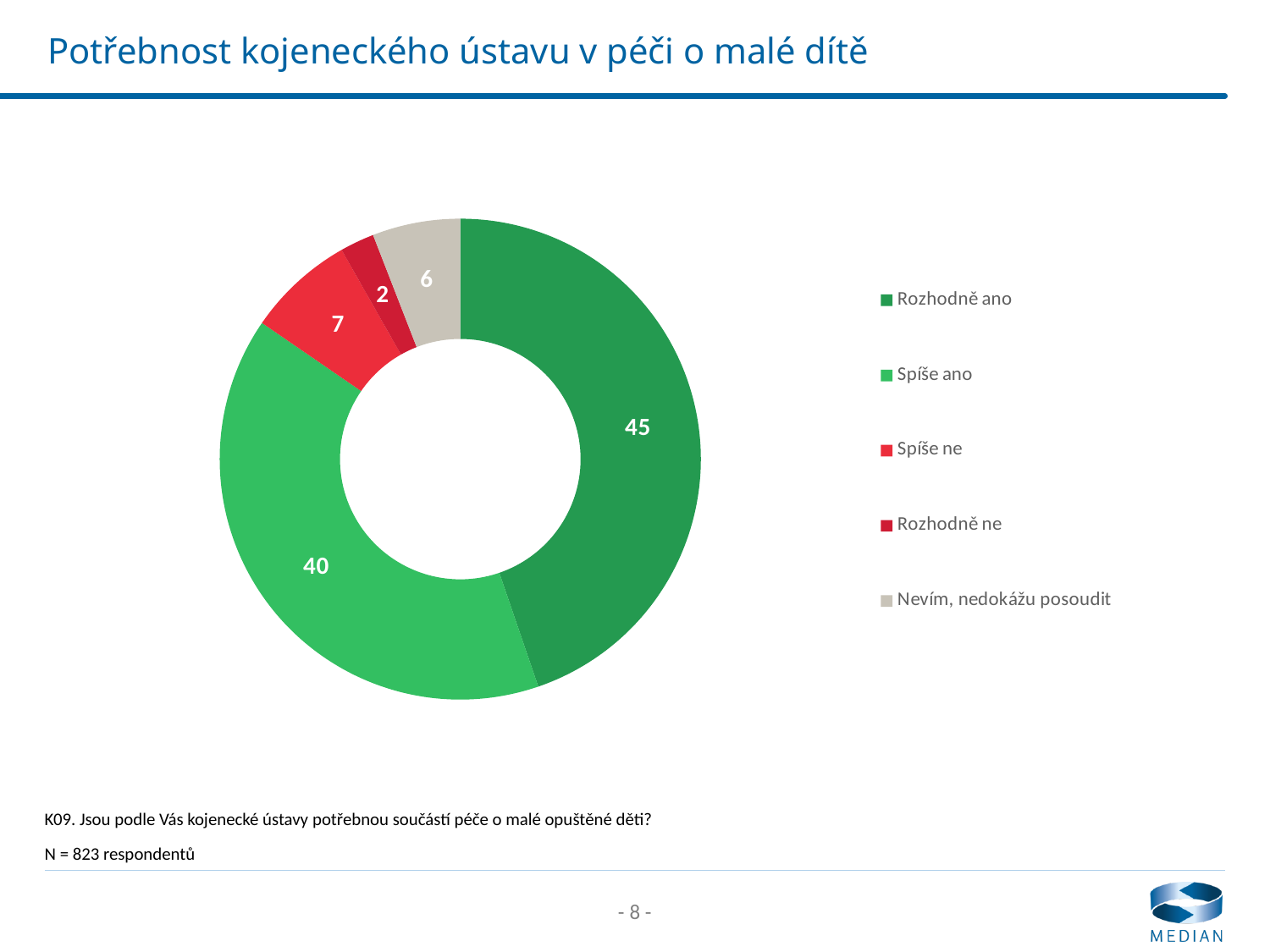
Which category has the largest slice? Rozhodně ano What is the value for "Rozhodně ne"? 2 What is the value for "Rozhodně ano"? 45 What is the difference between the values for "Rozhodně ano" and "Spíše ano"? 5 How many categories does the legend list? 5 What is the value for "Spíše ne"? 7 Which category has the smallest slice? Rozhodně ne What kind of chart is shown on the slide? Doughnut (pie) chart What is the value for "Nevím, nedokážu posoudit"? 6 What is the title of the slide containing the chart? Potřebnost kojeneckého ústavu v péči o malé dítě Which is larger, the value for "Spíše ne" or the value for "Nevím, nedokážu posoudit"? Spíše ne What is the value for "Spíše ano"? 40